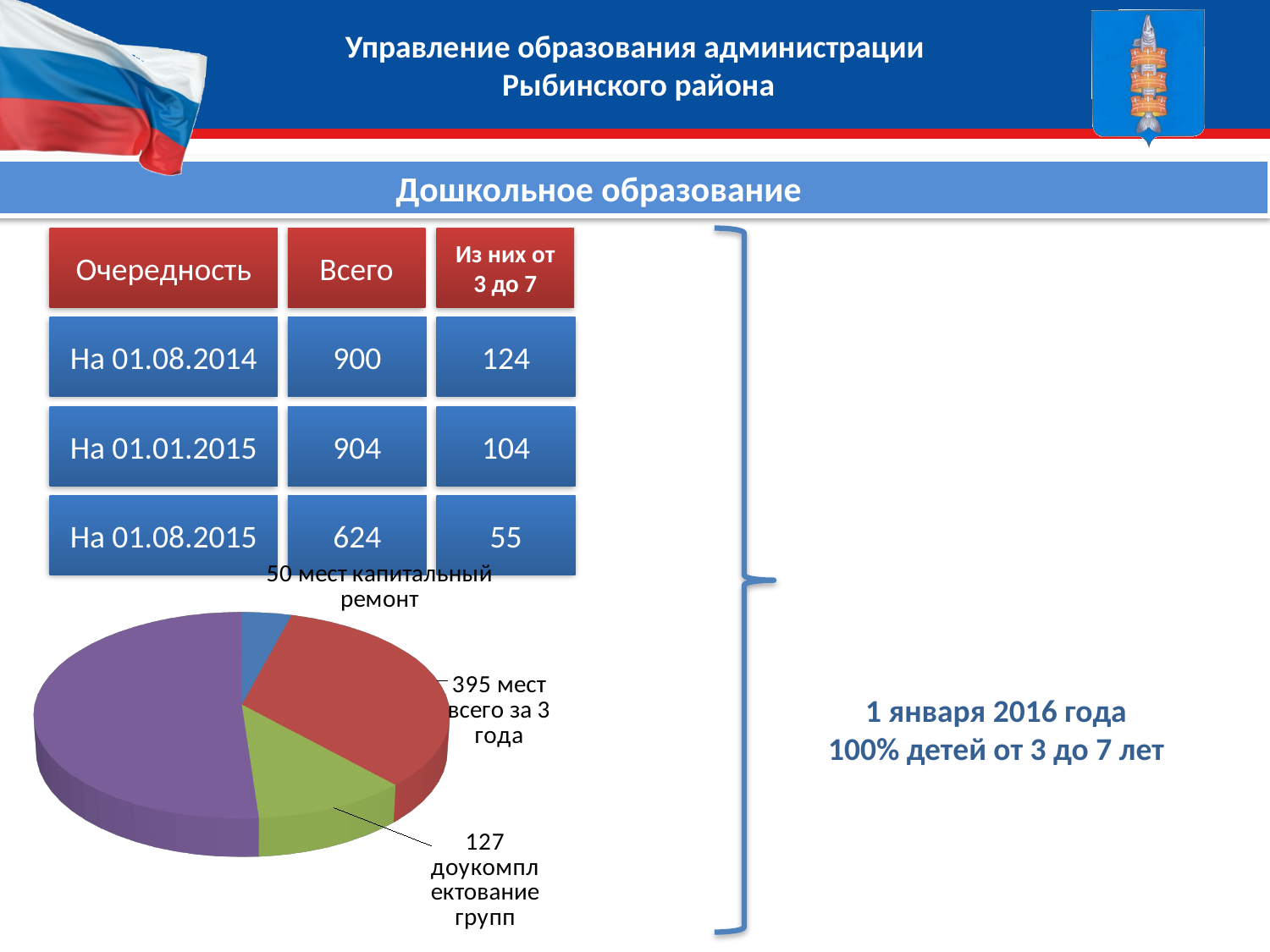
Which is larger in the pie chart: the value for 'доукомплектование групп' or the value for 'капитальный ремонт'? доукомплектование групп What colour is the slice labelled '50 мест капитальный ремонт' in the pie chart? blue Which labelled slice of the pie chart has the largest value? 395 мест всего за 3 года How many slices does the pie chart have? 4 What is the difference between the value for 'доукомплектование групп' (127) and the value for 'капитальный ремонт' (50) in the pie chart? 77 What kind of chart is shown on the slide? pie chart What value is shown for the slice labelled 'капитальный ремонт' in the pie chart? 50 мест Which labelled slice of the pie chart has the smallest value? 50 мест капитальный ремонт What value is shown for the slice labelled 'всего за 3 года' in the pie chart? 395 мест What colour is the slice labelled '127 доукомплектование групп' in the pie chart? green What value is shown for the slice labelled 'доукомплектование групп' in the pie chart? 127